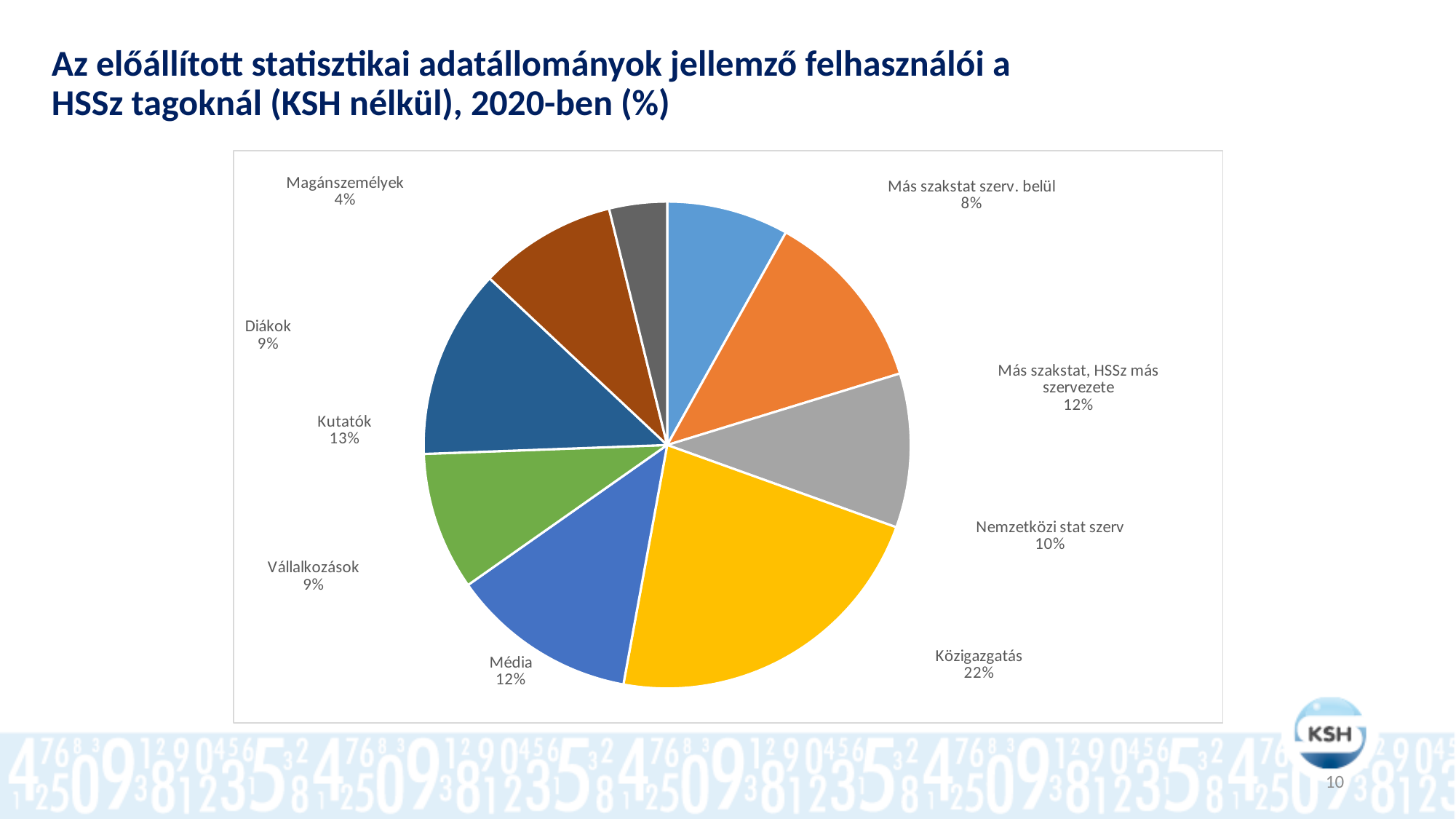
Which category has the largest slice of the pie? Közigazgatás How many slices does the pie chart have? 9 What share of the pie does Közigazgatás have? 22% What is the combined share of Diákok and Vállalkozások? 18% What kind of chart is shown on the slide? pie chart What is the value for Kutatók? 13% What is the value for Nemzetközi stat szerv? 10% What is the value for Magánszemélyek? 4% Which category has the smallest slice of the pie? Magánszemélyek What is the difference between the values for Közigazgatás and Kutatók? 9 percentage points Which is larger, the value for Média or the value for Diákok? Média What colour is the Közigazgatás slice? yellow